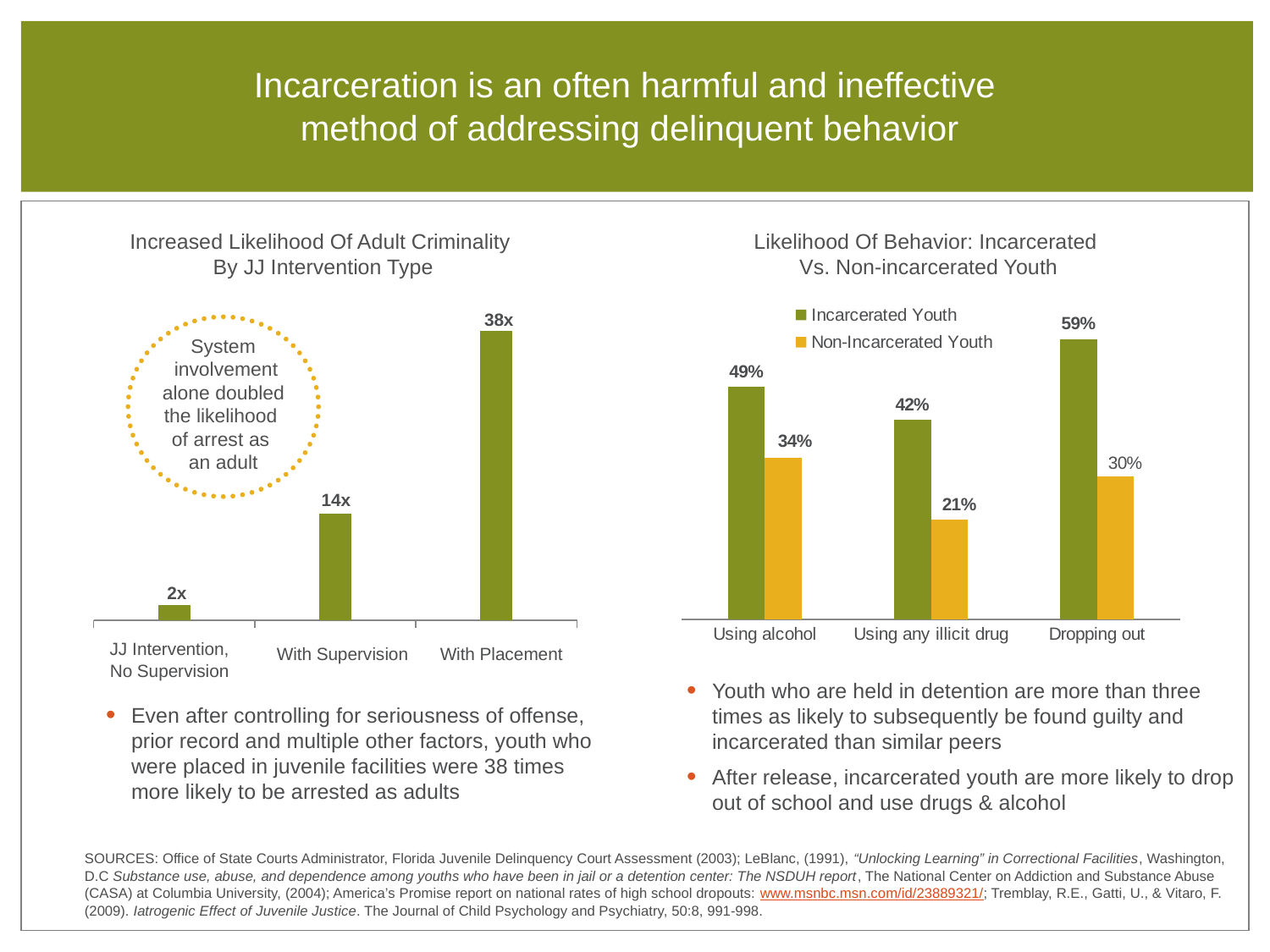
In the 'Likelihood Of Behavior: Incarcerated Vs. Non-incarcerated Youth' chart, which is larger: Incarcerated Youth for Using alcohol or Incarcerated Youth for Using any illicit drug? Using alcohol In the 'Likelihood Of Behavior: Incarcerated Vs. Non-incarcerated Youth' chart, what is the value for Non-Incarcerated Youth for Using any illicit drug? 21% In the 'Increased Likelihood Of Adult Criminality By JJ Intervention Type' chart, do the values rise or fall from left to right? rise In the 'Likelihood Of Behavior: Incarcerated Vs. Non-incarcerated Youth' chart, what is the value for Incarcerated Youth for Dropping out? 59% In the 'Increased Likelihood Of Adult Criminality By JJ Intervention Type' chart, what is the value for JJ Intervention, No Supervision? 2x In the 'Increased Likelihood Of Adult Criminality By JJ Intervention Type' chart, how many categories are shown on the x axis? 3 In the 'Likelihood Of Behavior: Incarcerated Vs. Non-incarcerated Youth' chart, what is the difference between Incarcerated Youth and Non-Incarcerated Youth for Using alcohol? 15% What kind of chart is the 'Likelihood Of Behavior: Incarcerated Vs. Non-incarcerated Youth' chart? bar chart In the 'Increased Likelihood Of Adult Criminality By JJ Intervention Type' chart, what is the value for With Placement? 38x In the 'Increased Likelihood Of Adult Criminality By JJ Intervention Type' chart, which category has the highest value? With Placement In the 'Likelihood Of Behavior: Incarcerated Vs. Non-incarcerated Youth' chart, which category has the lowest Non-Incarcerated Youth value? Using any illicit drug How many series does the legend of the 'Likelihood Of Behavior: Incarcerated Vs. Non-incarcerated Youth' chart list? 2